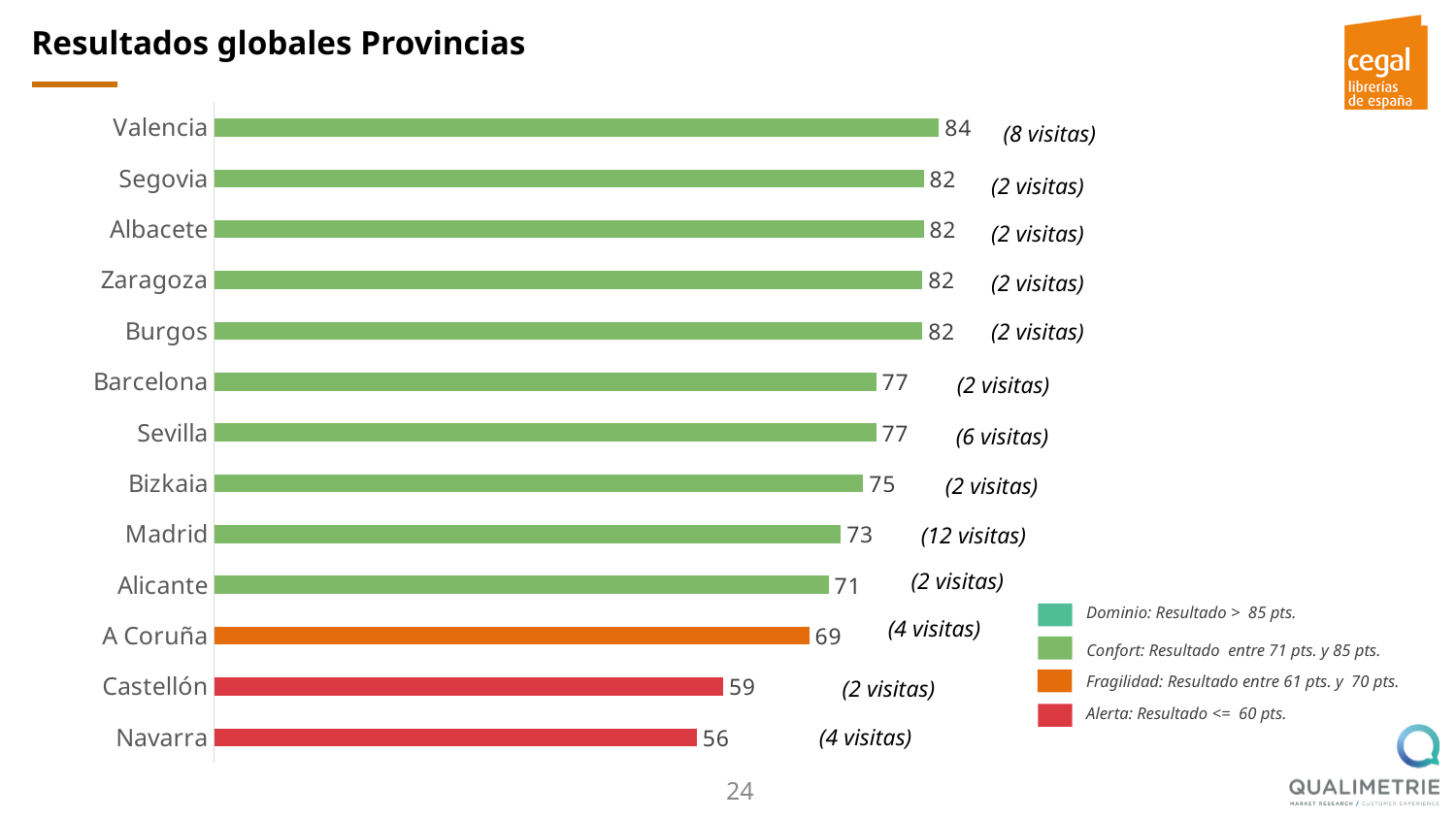
Which has a larger value, Sevilla or Alicante? Sevilla What colour are the bars for Castellón and Navarra? Red What is the difference between the values for Valencia and Navarra? 28 What is the difference between the values for Bizkaia and Castellón? 16 What is the value for A Coruña? 69 Which province has the highest value? Valencia Which province has the lowest value? Navarra What kind of chart is shown on the slide? Bar chart What is the value for Valencia? 84 How many visits are indicated next to the Madrid bar? 12 visitas How many provinces are shown in the chart? 13 What is the value for Madrid? 73